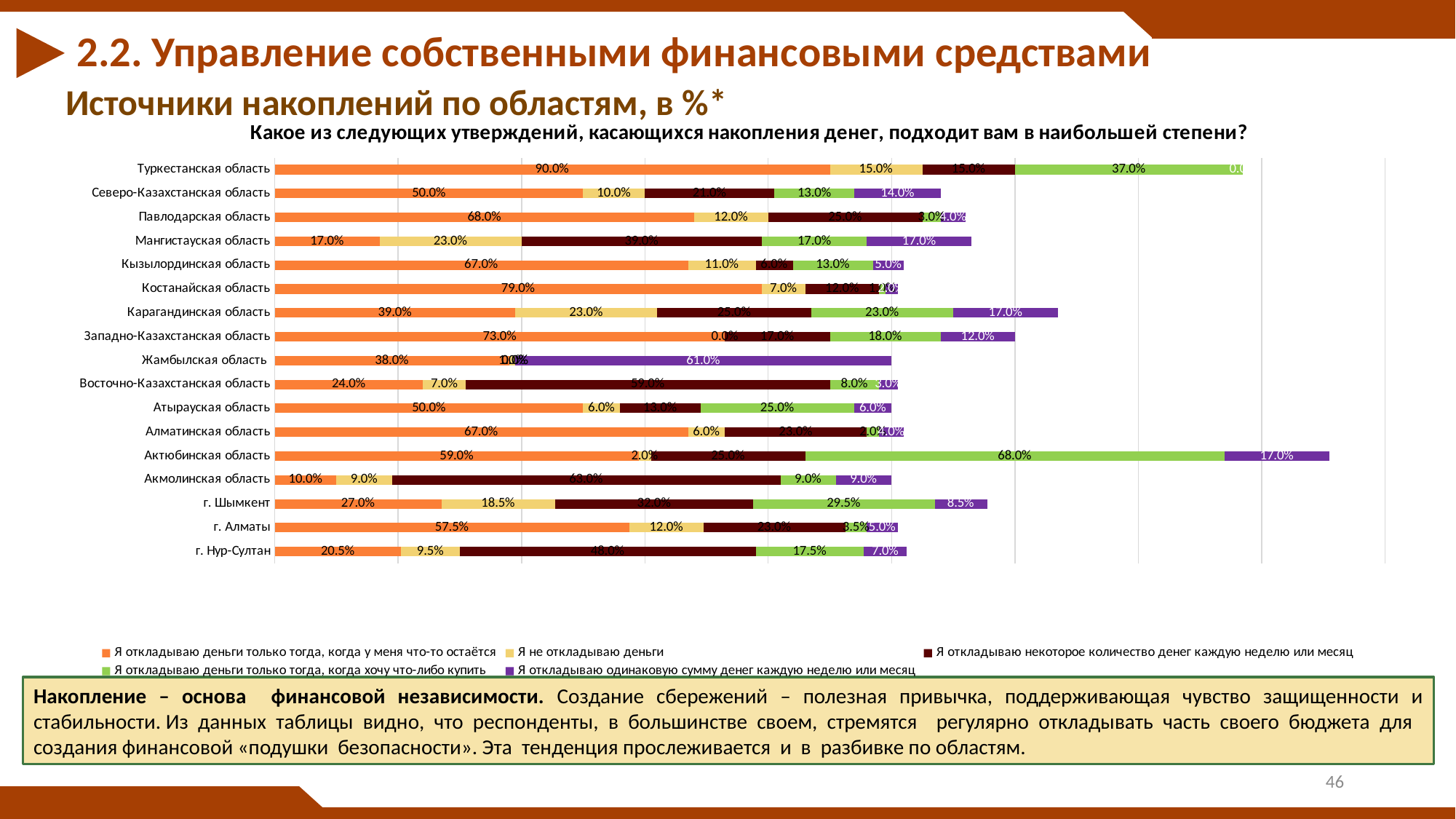
Which region has the highest value in the series 'Я откладываю деньги только тогда, когда у меня что-то остаётся'? Туркестанская область What kind of chart is shown on the slide? Stacked bar chart What is the value for Жамбылская область in the series 'Я откладываю одинаковую сумму денег каждую неделю или месяц'? 61.0% What is the value for Туркестанская область in the series 'Я откладываю деньги только тогда, когда у меня что-то остаётся'? 90.0% Which region has the lowest value in the series 'Я откладываю деньги только тогда, когда у меня что-то остаётся'? Акмолинская область How many regions (categories) are listed on the chart? 17 What is the value for г. Шымкент in the series 'Я не откладываю деньги'? 18.5% How many series does the legend list? 5 What is the title of the chart? Какое из следующих утверждений, касающихся накопления денег, подходит вам в наибольшей степени? What is the difference between the 'Я откладываю деньги только тогда, когда у меня что-то остаётся' values for Костанайская область and Карагандинская область? 40.0% Which is larger: the 'Я откладываю деньги только тогда, когда хочу что-либо купить' value for Атырауская область or for Северо-Казахстанская область? Атырауская область What is the value for Актюбинская область in the series 'Я откладываю деньги только тогда, когда хочу что-либо купить'? 68.0%